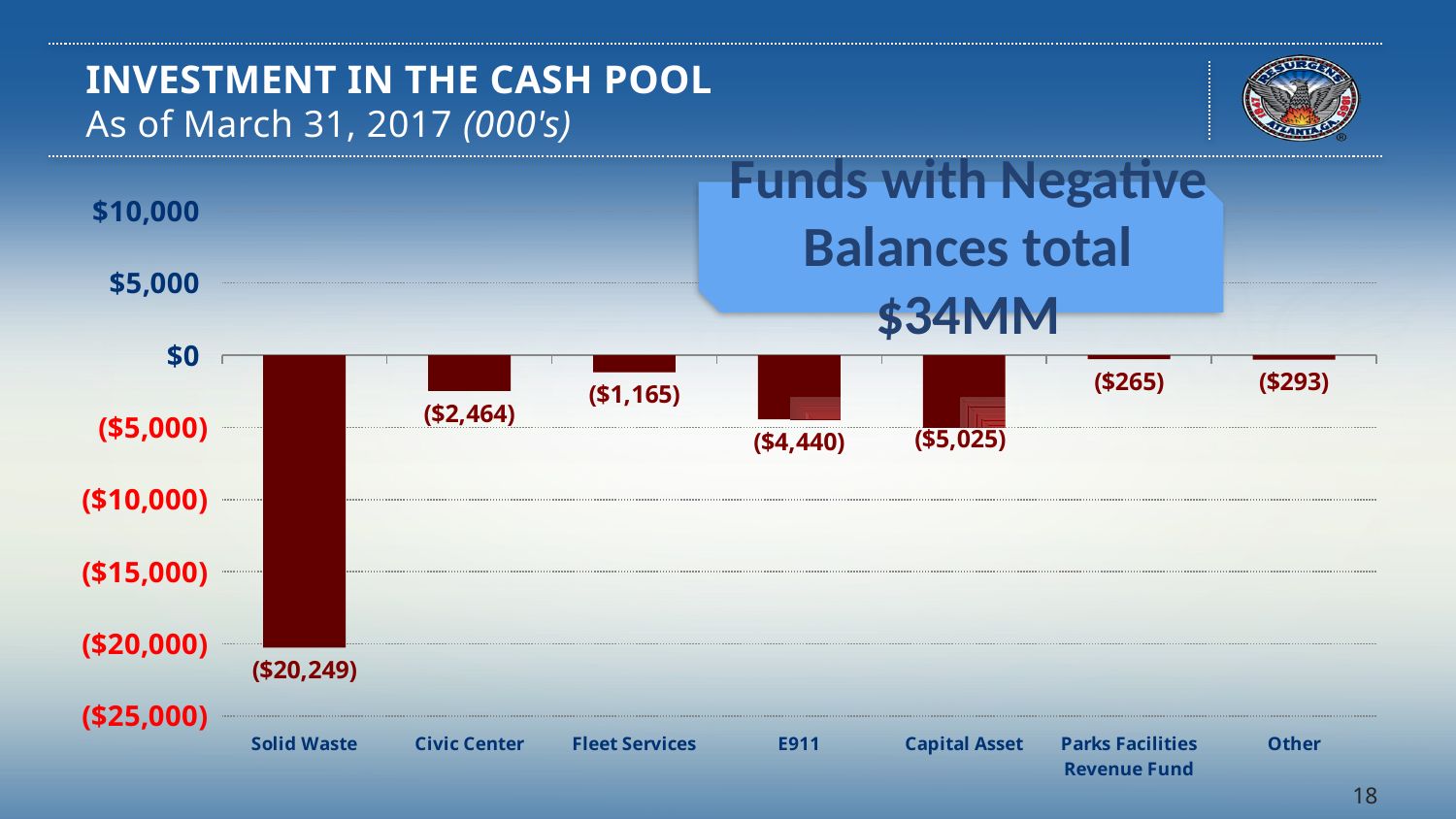
What is the value for Capital Asset? ($5,025) How many categories are shown on the x axis? 7 What kind of chart is shown on the slide? Bar chart Which has the larger negative balance, Civic Center or Fleet Services? Civic Center Which category has the highest value (closest to zero)? Parks Facilities Revenue Fund What is the difference between the Capital Asset and E911 values? $585 Which category has the lowest (most negative) value? Solid Waste What is the value for Civic Center? ($2,464) What is the value for E911? ($4,440) What is the value for Solid Waste? ($20,249) What is the value for Fleet Services? ($1,165) What is the value for Parks Facilities Revenue Fund? ($265)